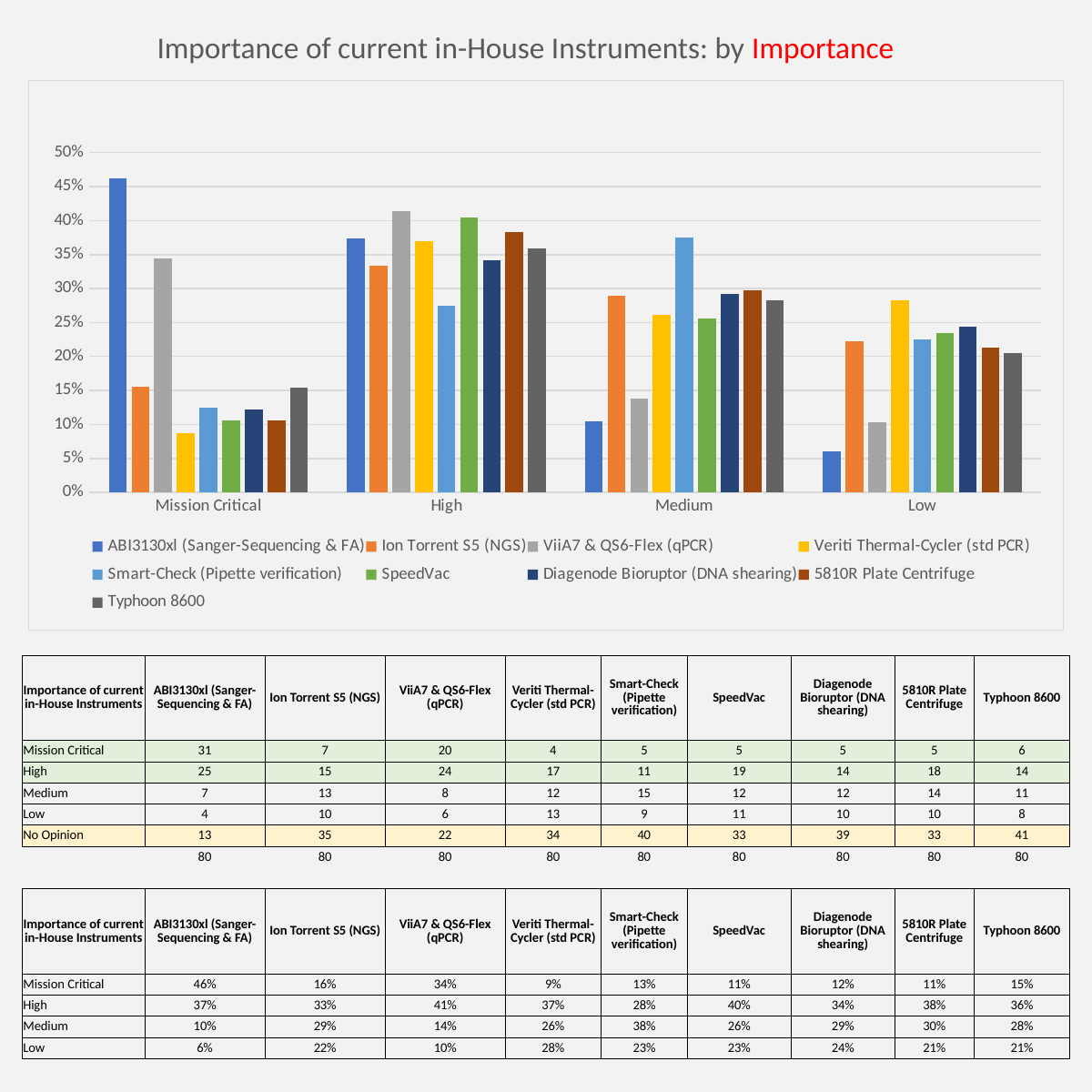
Do the values for ABI3130xl (Sanger-Sequencing & FA) rise or fall from Mission Critical to Low? fall Which instrument has the lowest value in the Mission Critical category? Veriti Thermal-Cycler (std PCR) Is the Medium value for Smart-Check (Pipette verification) greater or less than 35%? greater What is the Low percentage for Typhoon 8600? 21% What is the High percentage for ViiA7 & QS6-Flex (qPCR)? 41% In the Medium category, which is larger: Ion Torrent S5 (NGS) or ViiA7 & QS6-Flex (qPCR)? Ion Torrent S5 (NGS) How many importance categories are shown along the x axis of the chart? 4 How many series does the chart legend list? 9 Is the Mission Critical value for ABI3130xl (Sanger-Sequencing & FA) greater or less than 40%? greater What kind of chart is shown on the slide? bar chart Which instrument has the highest value in the Mission Critical category? ABI3130xl (Sanger-Sequencing & FA) What is the difference between the Mission Critical and Low percentages for ABI3130xl (Sanger-Sequencing & FA)? 40 percentage points